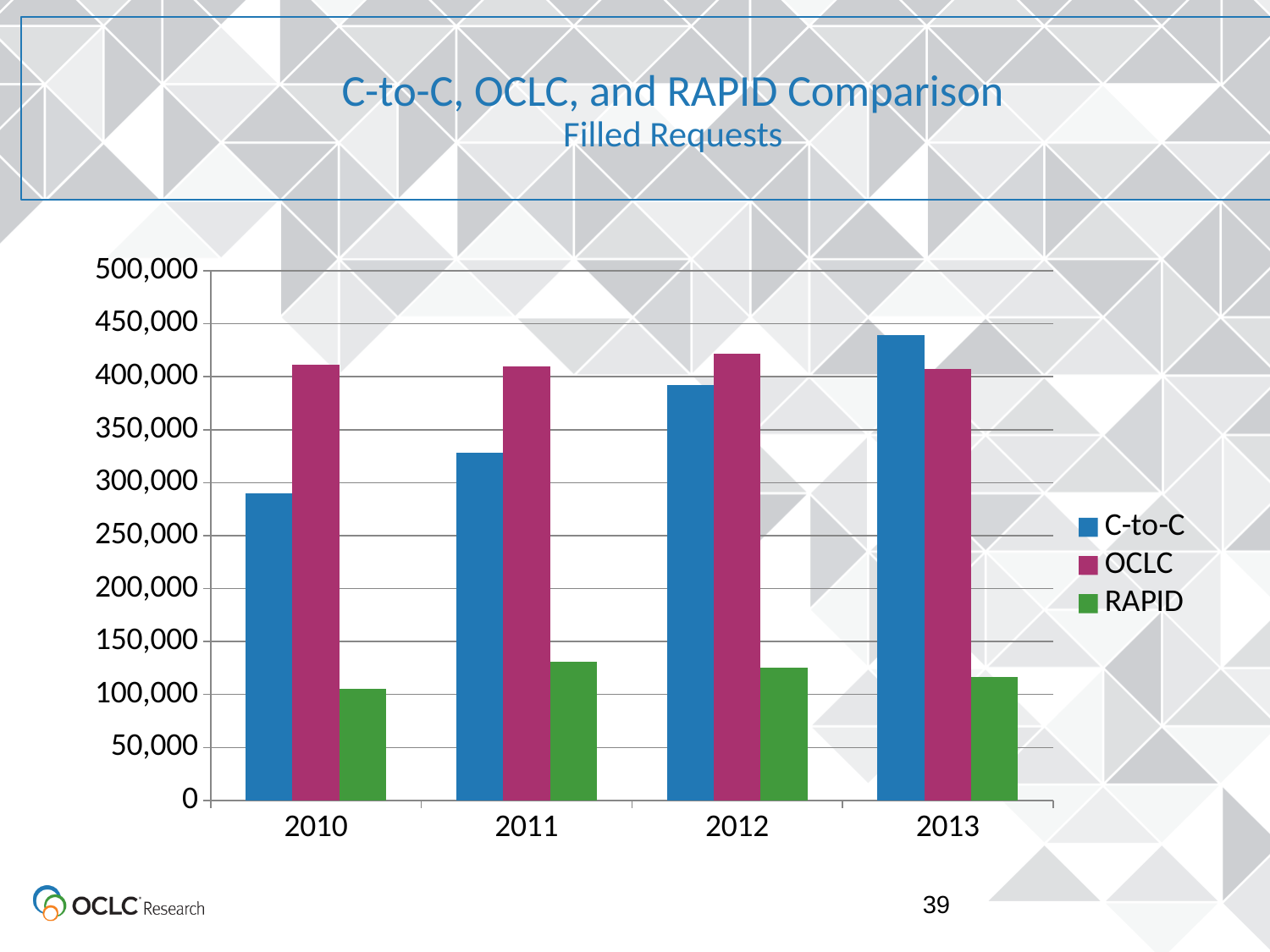
In 2013, which is larger, C-to-C or OCLC? C-to-C What is the title of the chart on the slide? C-to-C, OCLC, and RAPID Comparison Filled Requests In 2010, which is larger, C-to-C or OCLC? OCLC What kind of chart is shown on the slide? bar chart How many years are shown on the x axis? 4 Is the C-to-C value for 2010 greater or less than 300,000? less Is the OCLC value for 2012 greater or less than 400,000? greater How many series does the legend list? 3 Do the C-to-C values rise or fall from 2010 to 2013? rise Which series has the lowest value in 2010? RAPID Is the RAPID value for 2011 greater or less than 100,000? greater In which year is the C-to-C value highest? 2013